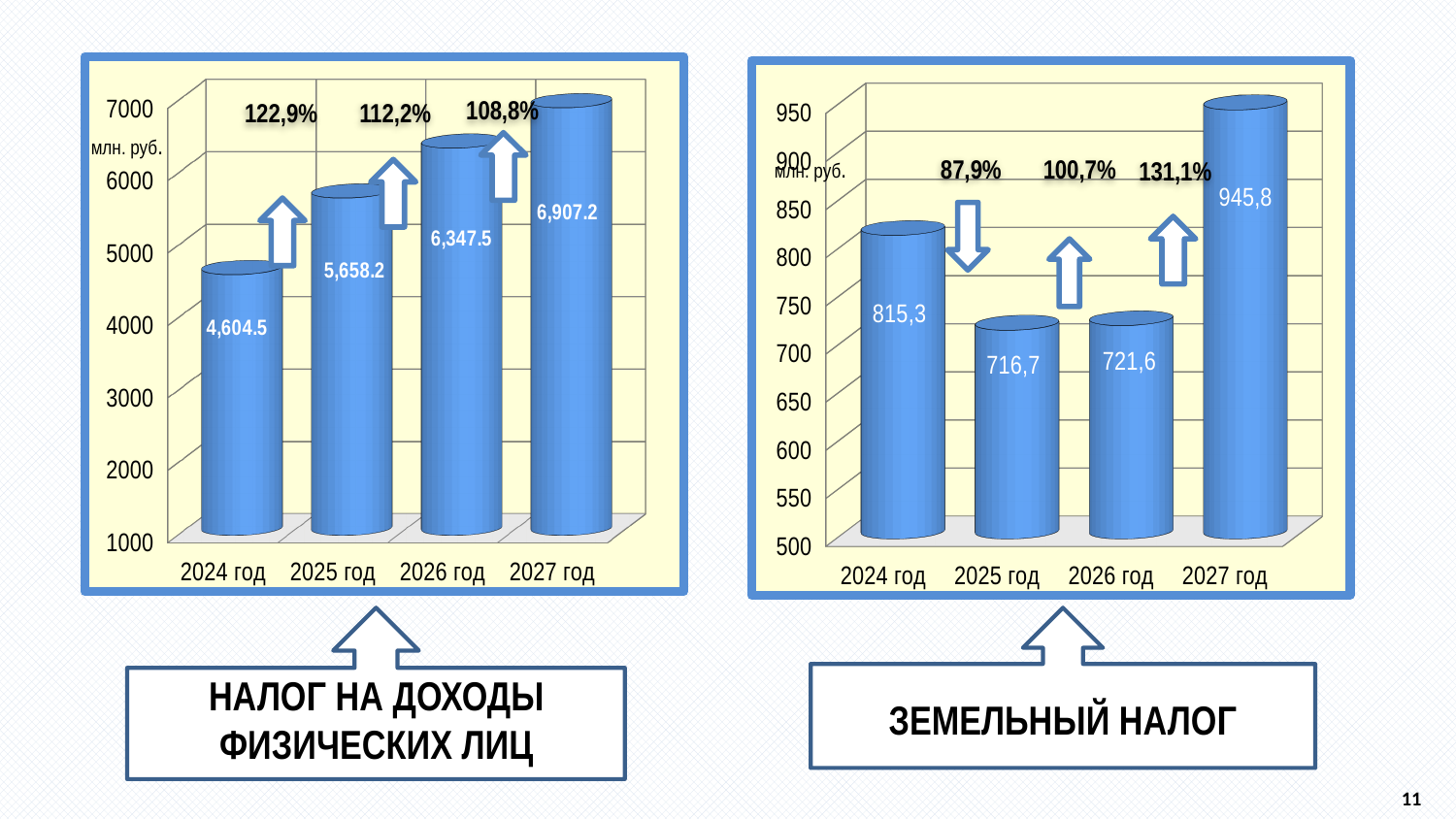
In the left chart (НАЛОГ НА ДОХОДЫ ФИЗИЧЕСКИХ ЛИЦ), which year has the lowest value? 2024 год In the left chart (НАЛОГ НА ДОХОДЫ ФИЗИЧЕСКИХ ЛИЦ), what is the difference between the values for 2027 год and 2024 год? 2,302.7 In the right chart (ЗЕМЕЛЬНЫЙ НАЛОГ), what is the value for 2025 год? 716,7 In the right chart (ЗЕМЕЛЬНЫЙ НАЛОГ), which year has the highest value? 2027 год How many years are shown on the x axis of the right chart (ЗЕМЕЛЬНЫЙ НАЛОГ)? 4 In the right chart (ЗЕМЕЛЬНЫЙ НАЛОГ), which is larger, the value for 2024 год or the value for 2026 год? 2024 год In the left chart (НАЛОГ НА ДОХОДЫ ФИЗИЧЕСКИХ ЛИЦ), what percentage is shown above the arrow between 2024 год and 2025 год? 122,9% In the left chart (НАЛОГ НА ДОХОДЫ ФИЗИЧЕСКИХ ЛИЦ), do the values rise or fall from 2024 год to 2027 год? rise In the right chart (ЗЕМЕЛЬНЫЙ НАЛОГ), what is the difference between the values for 2027 год and 2025 год? 229,1 In the right chart (ЗЕМЕЛЬНЫЙ НАЛОГ), which year has the lowest value? 2025 год In the left chart (НАЛОГ НА ДОХОДЫ ФИЗИЧЕСКИХ ЛИЦ), what is the value for 2027 год? 6,907.2 In the left chart (НАЛОГ НА ДОХОДЫ ФИЗИЧЕСКИХ ЛИЦ), what is the value for 2024 год? 4,604.5